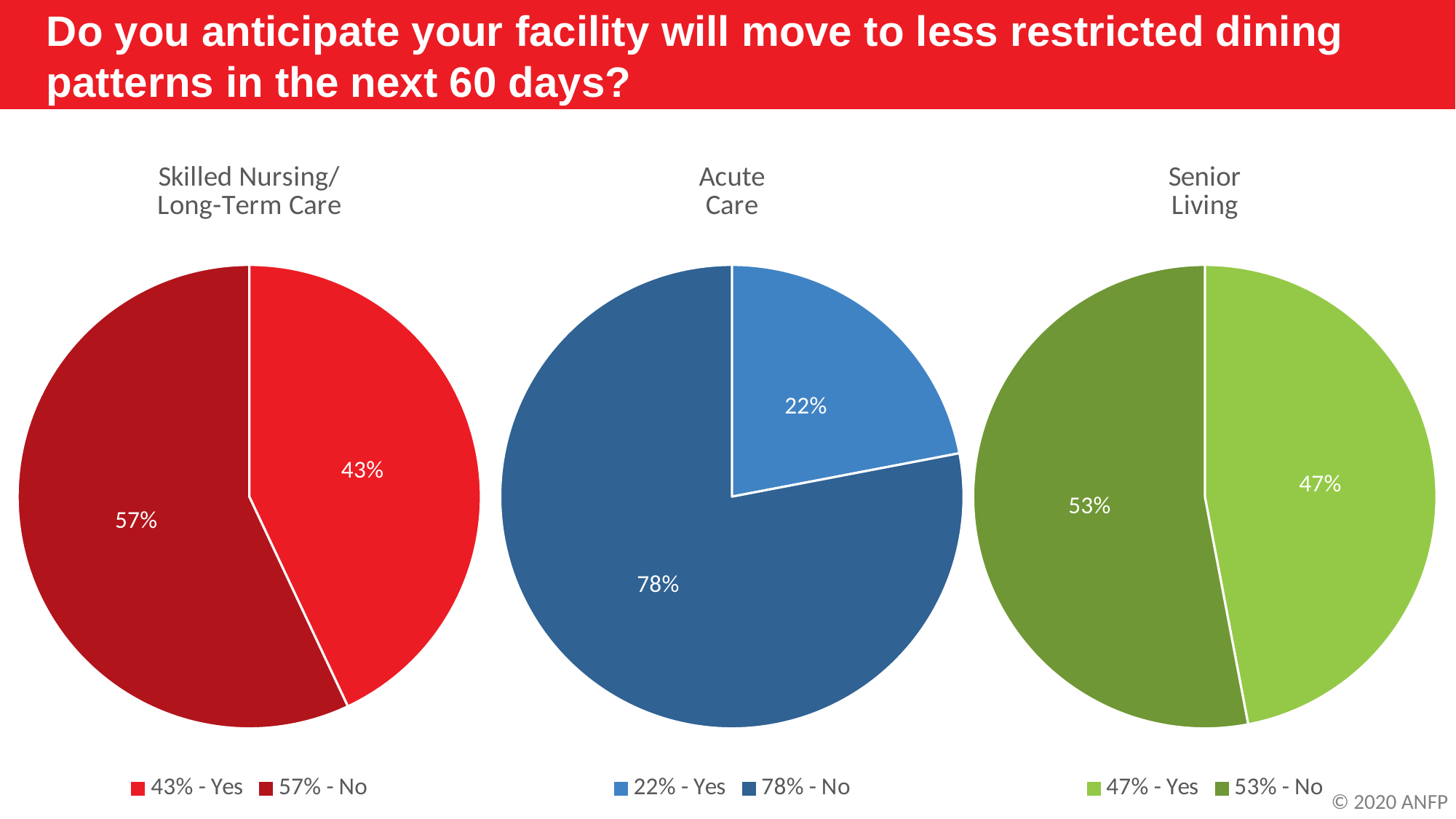
In the Acute Care chart, what is the difference between the No and Yes percentages? 56% In the Acute Care chart, what percentage answered No? 78% In the Skilled Nursing/Long-Term Care chart, which response has the smallest slice? Yes What colour is the Yes slice in the Acute Care chart? Light blue In the Senior Living chart, what is the difference between the No and Yes percentages? 6% In the Skilled Nursing/Long-Term Care chart, what percentage answered Yes? 43% In the Senior Living chart, which is larger, the Yes slice or the No slice? No What kind of chart is used for the Acute Care data? Pie chart In the Senior Living chart, what percentage answered Yes? 47% In the Acute Care chart, which response has the largest slice? No How many slices does the Skilled Nursing/Long-Term Care pie chart have? 2 How many entries does the legend of the Senior Living chart list? 2